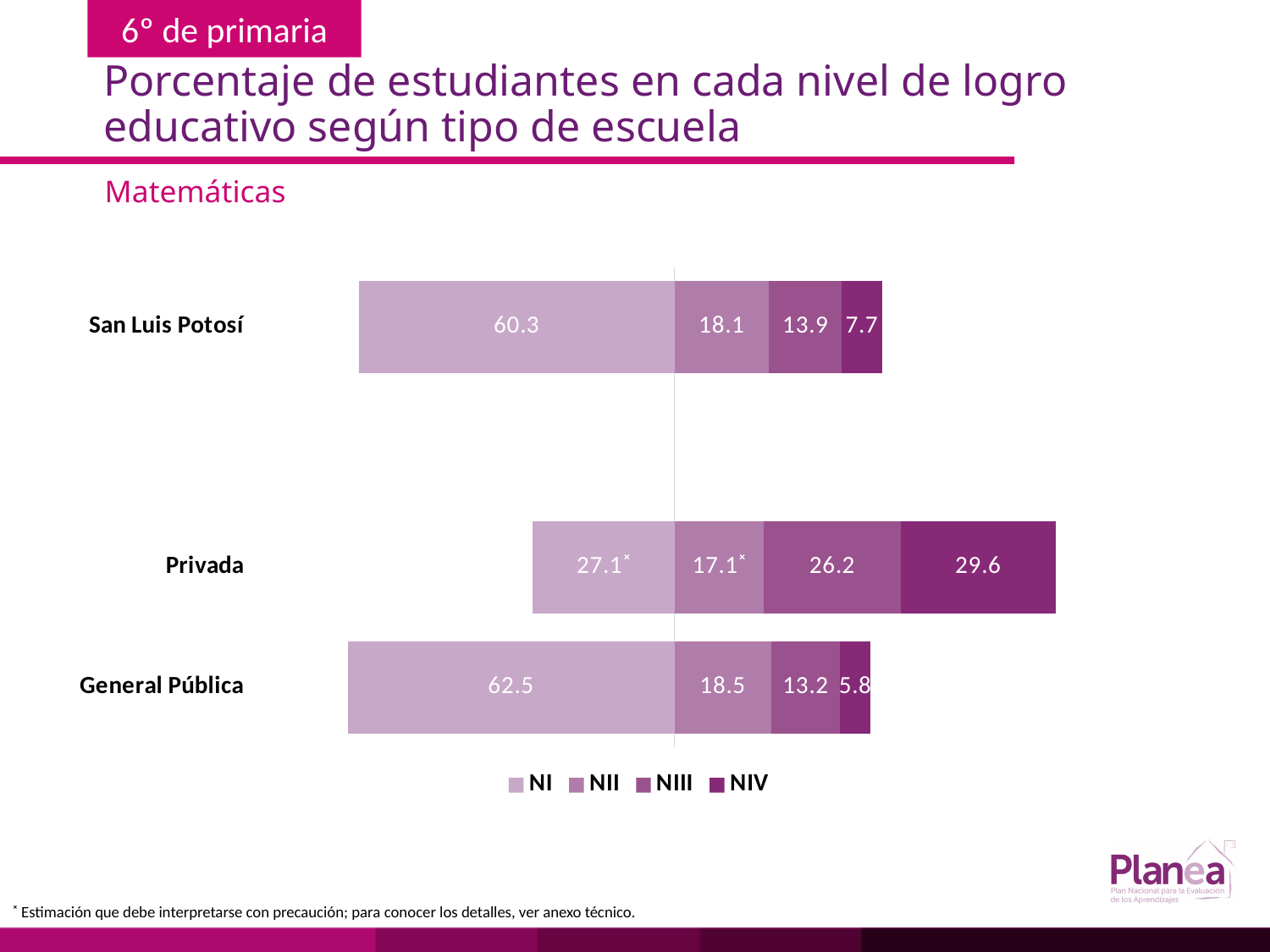
What kind of chart is shown on the slide? Stacked bar chart How many categories (school types) are shown on the chart? 3 Which category has the lowest NIV value? General Pública How many series does the legend list? 4 What is the total of the stacked bar for Privada? 100.0 What is the difference between the NI values for General Pública and Privada? 35.4 What is the NIV value for Privada schools? 29.6 Which subject does the chart refer to? Matemáticas What is the NIII value for San Luis Potosí? 13.9 What percentage of students in General Pública schools are at level NI in Matemáticas? 62.5 Which is larger: the NIV value for Privada or the NIV value for San Luis Potosí? Privada Which school type has the highest NI value? General Pública